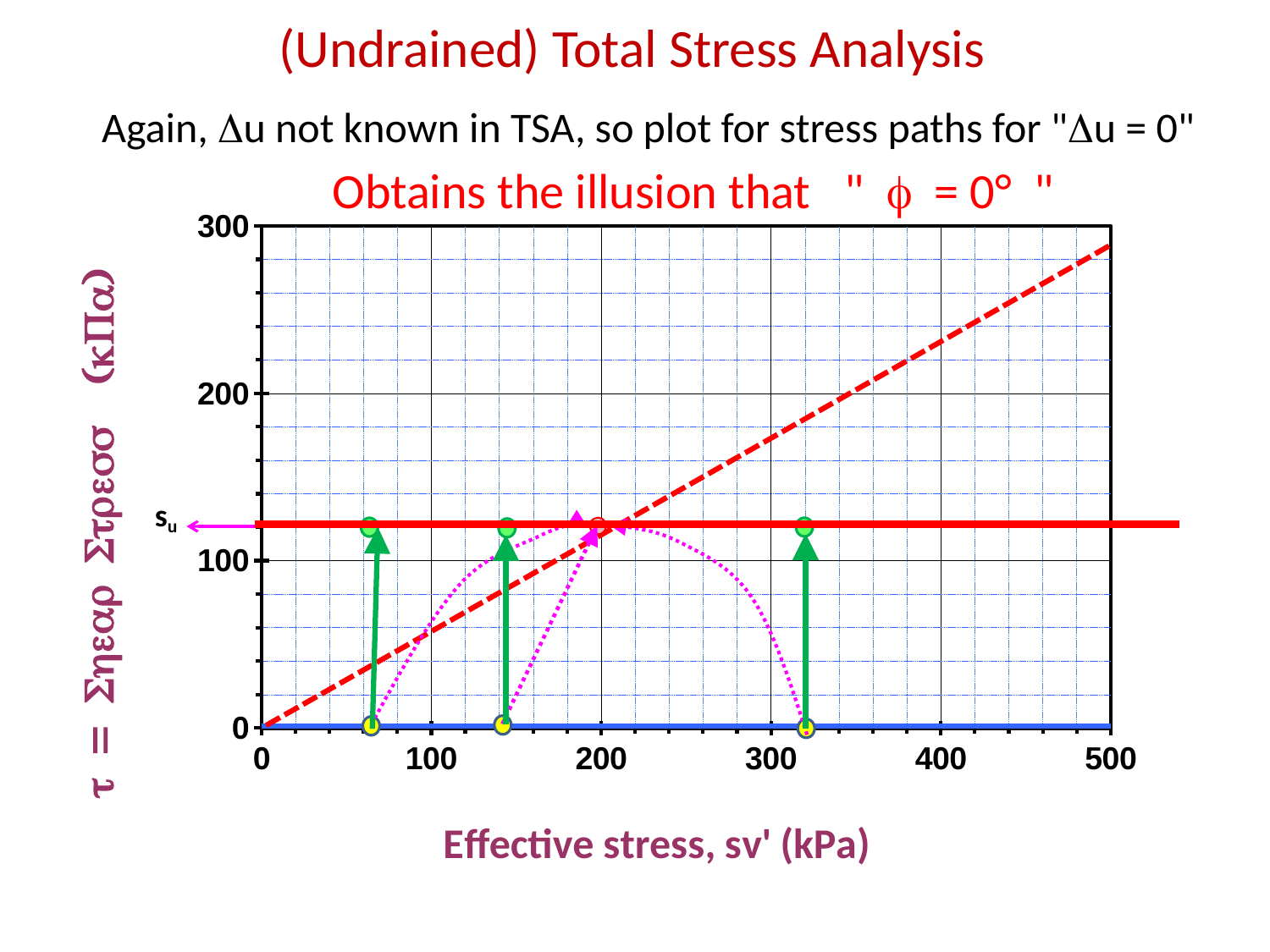
What is the highest tick value shown on the x axis? 500 Does the solid red line labelled s_u rise, fall or stay constant along the x axis? stay constant What kind of chart is shown on the slide? line chart Is the value of the horizontal red line labelled s_u greater or less than 200? less Which is larger at an effective stress of 400: the dashed red line or the solid red line labelled s_u? the dashed red line How many green vertical arrows are plotted on the chart? 3 What is the label of the x axis? Effective stress, sv' (kPa) Which is larger at an effective stress of 100: the dashed red line or the solid red line labelled s_u? the solid red line labelled s_u Is the value of the horizontal red line labelled s_u greater or less than 100? greater Does the dashed red line rise or fall as effective stress increases along the x axis? rise What is the highest tick value shown on the y axis? 300 Is the value of the dashed red line at an effective stress of 500 greater or less than 200? greater